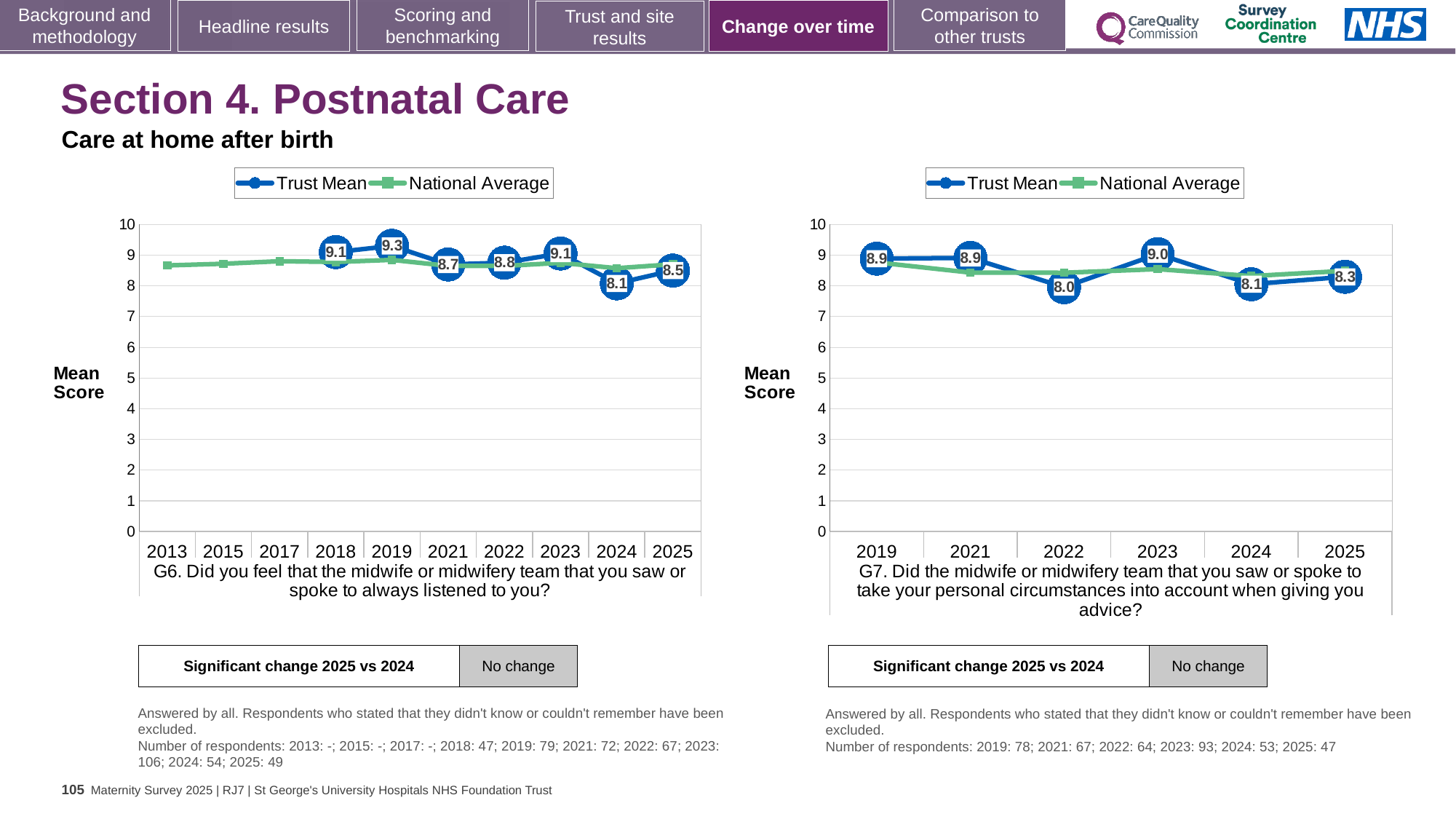
In the left chart (G6), which year has the lowest Trust Mean score? 2024 In the right chart (G7), is the Trust Mean score for 2025 higher or lower than for 2024? higher In the right chart (G7), how many series does the legend list? 2 In the right chart (G7), what is the difference between the Trust Mean scores for 2023 and 2022? 1.0 In the left chart (G6), what is the Trust Mean score for 2019? 9.3 In the right chart (G7), which year has the highest Trust Mean score? 2023 In the left chart (G6), what is the difference between the Trust Mean scores for 2019 and 2024? 1.2 What type of chart is the left chart (G6)? line chart In the left chart (G6), which year has the highest Trust Mean score? 2019 In the left chart (G6), how many years are shown on the x axis? 10 In the left chart (G6), what is the Trust Mean score for 2024? 8.1 In the right chart (G7), what is the Trust Mean score for 2022? 8.0